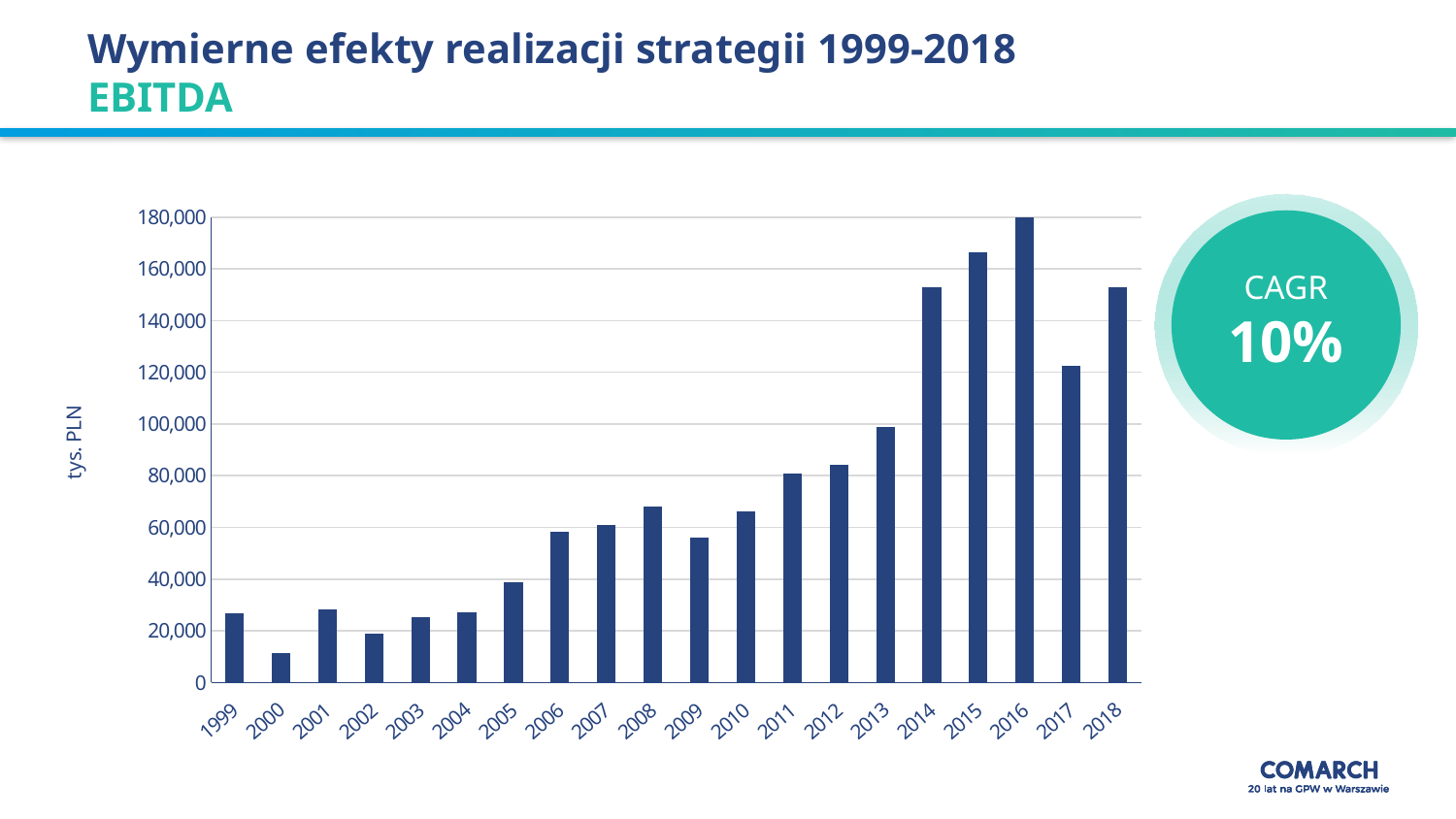
Which year has the highest EBITDA bar? 2016 Which is larger, the value for 2009 or the value for 2010? 2010 How many years are plotted on the x axis? 20 What unit is shown on the y axis label? tys. PLN Is the value for 2016 greater or less than 160,000? greater Is the value for 2000 greater or less than 20,000? less Which is larger, the value for 2015 or the value for 2017? 2015 What kind of chart is shown on the slide? bar chart Overall, do the EBITDA values rise or fall from 1999 to 2018? rise Which year has the lowest EBITDA bar? 2000 Is the value for 2017 greater or less than 120,000? greater